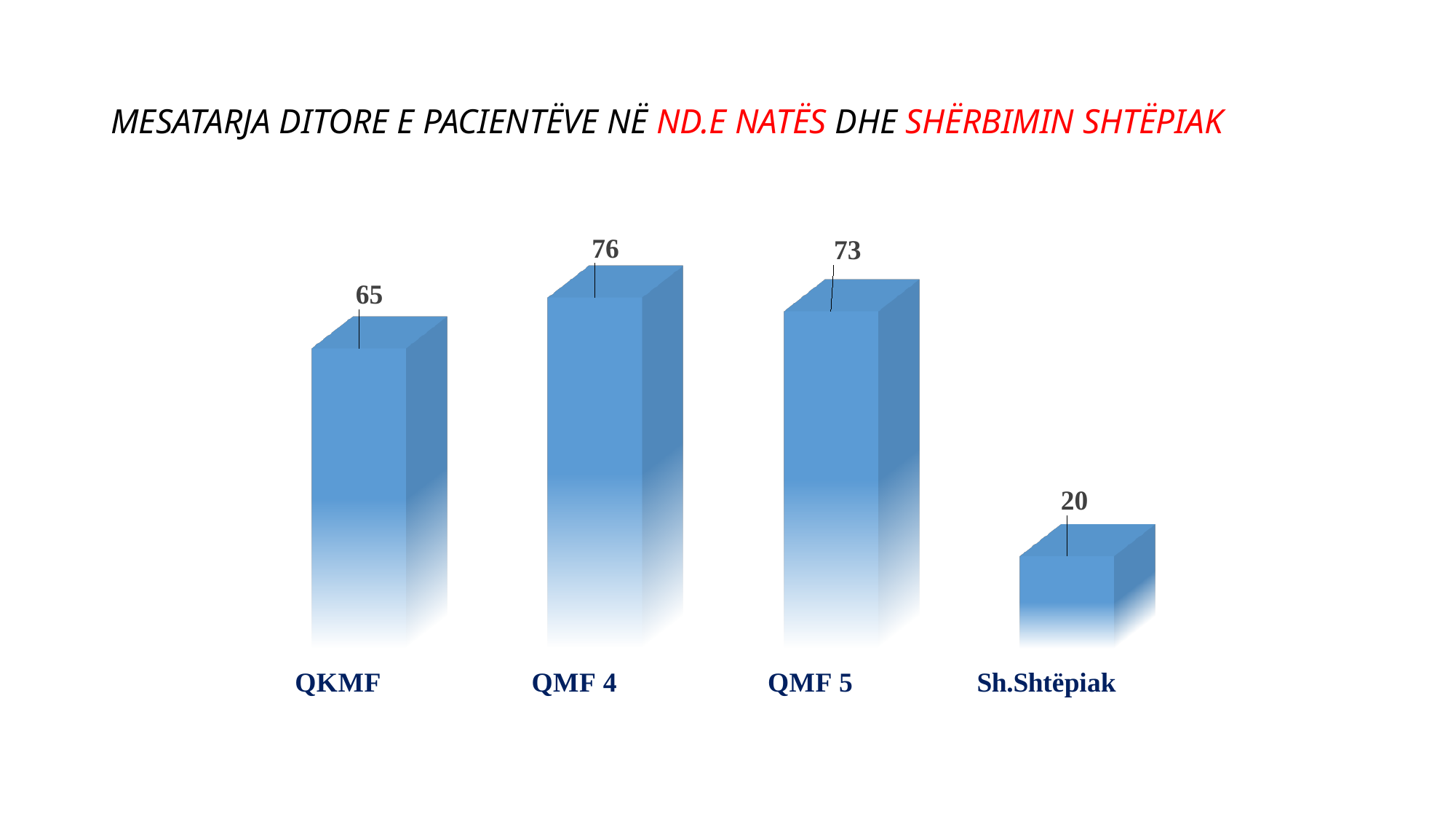
What kind of chart is shown on the slide? bar chart What is the value for QKMF? 65 What is the value for Sh.Shtëpiak? 20 Which category has the highest value? QMF 4 What is the difference between the values for QMF 5 and Sh.Shtëpiak? 53 What is the difference between the values for QMF 4 and QKMF? 11 Which category has the lowest value? Sh.Shtëpiak What is the title of the slide? MESATARJA DITORE E PACIENTËVE NË ND.E NATËS DHE SHËRBIMIN SHTËPIAK What is the value for QMF 4? 76 What is the value for QMF 5? 73 How many categories are shown in the chart? 4 Which is larger, the value for QKMF or the value for QMF 5? QMF 5